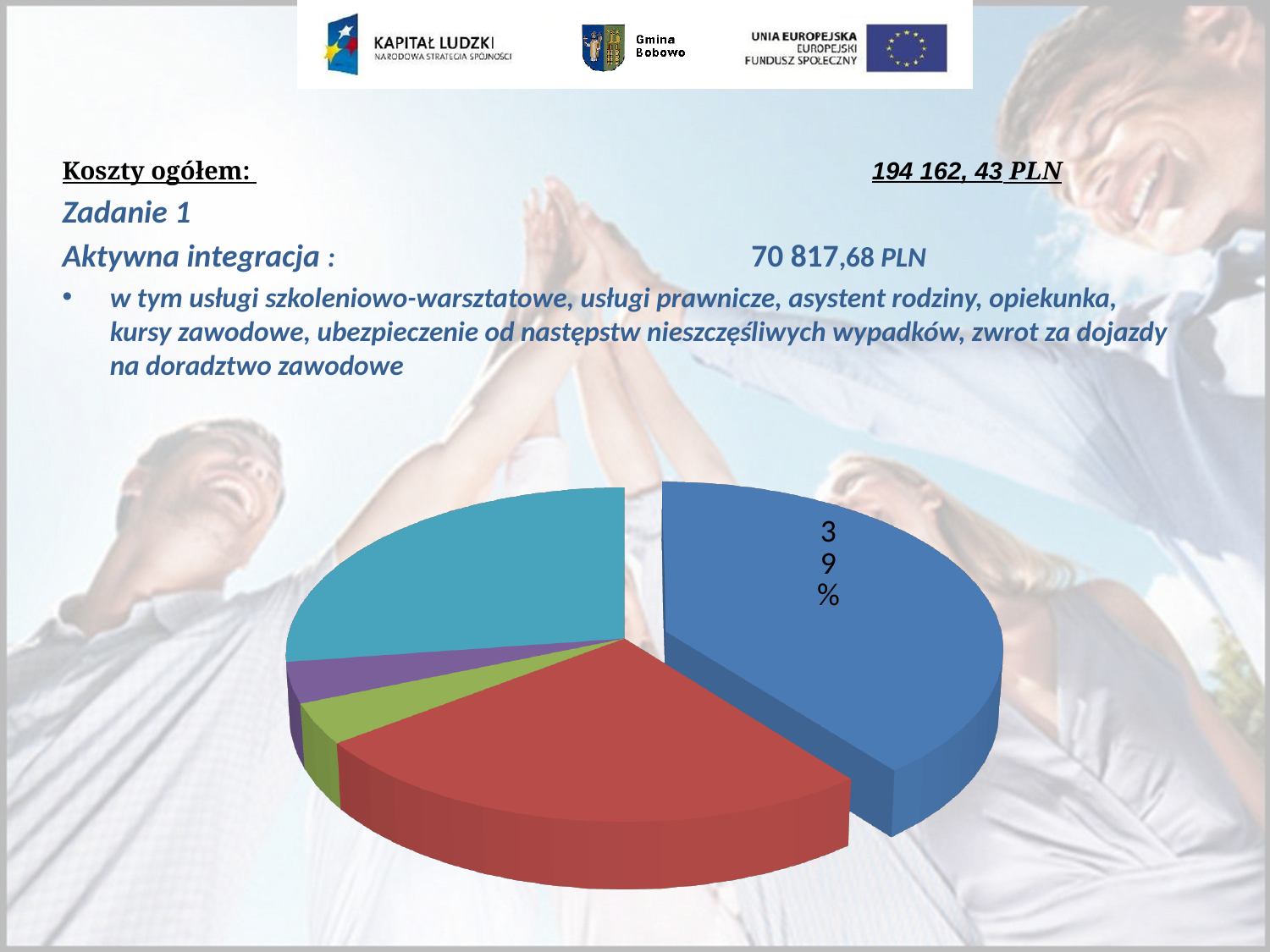
What percentage is printed on the blue slice of the pie chart? 39% What share of the pie does the blue slice represent? 39% Does the pie chart display a legend? No What colour is the slice labelled 39% in the pie chart? blue Which is larger in the pie chart, the teal slice or the green slice? the teal slice Which slice of the pie chart is the largest? the blue slice Which is larger in the pie chart, the blue slice or the red slice? the blue slice What kind of chart is shown on the slide? pie chart How many slices does the pie chart have? 5